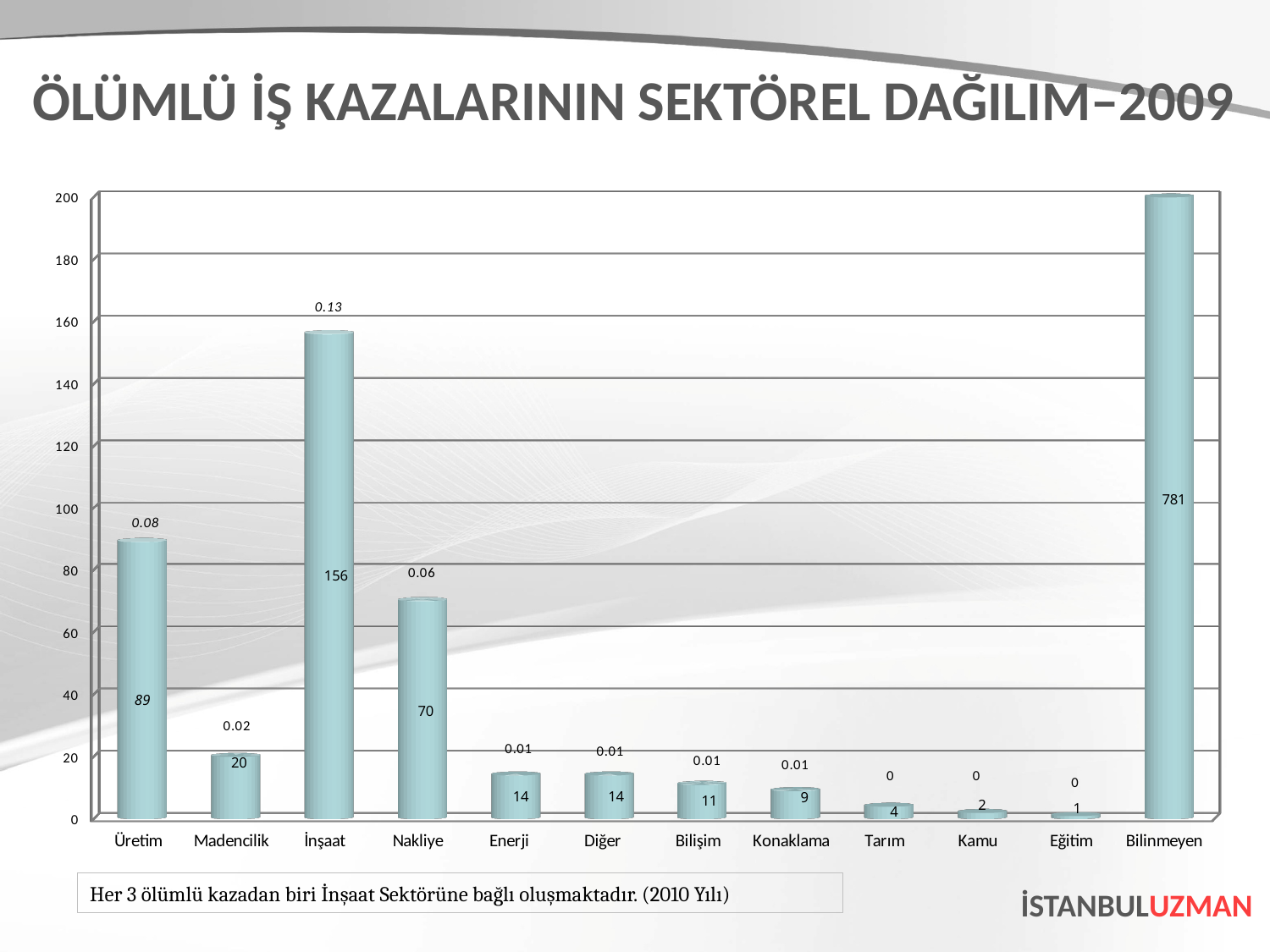
What is the value for Bilinmeyen? 781 What is the difference between the values for İnşaat and Nakliye? 86 Which is larger, the value for Üretim or the value for Nakliye? Üretim What is the value for Madencilik? 20 What is the value for İnşaat? 156 What is the value for Nakliye? 70 How many categories are shown on the x axis? 12 What kind of chart is shown on the slide? Bar chart What is the title of the slide? ÖLÜMLÜ İŞ KAZALARININ SEKTÖREL DAĞILIM-2009 Which category has the lowest value? Eğitim Which category has the highest value? Bilinmeyen Is the value for Üretim greater or less than 80? greater